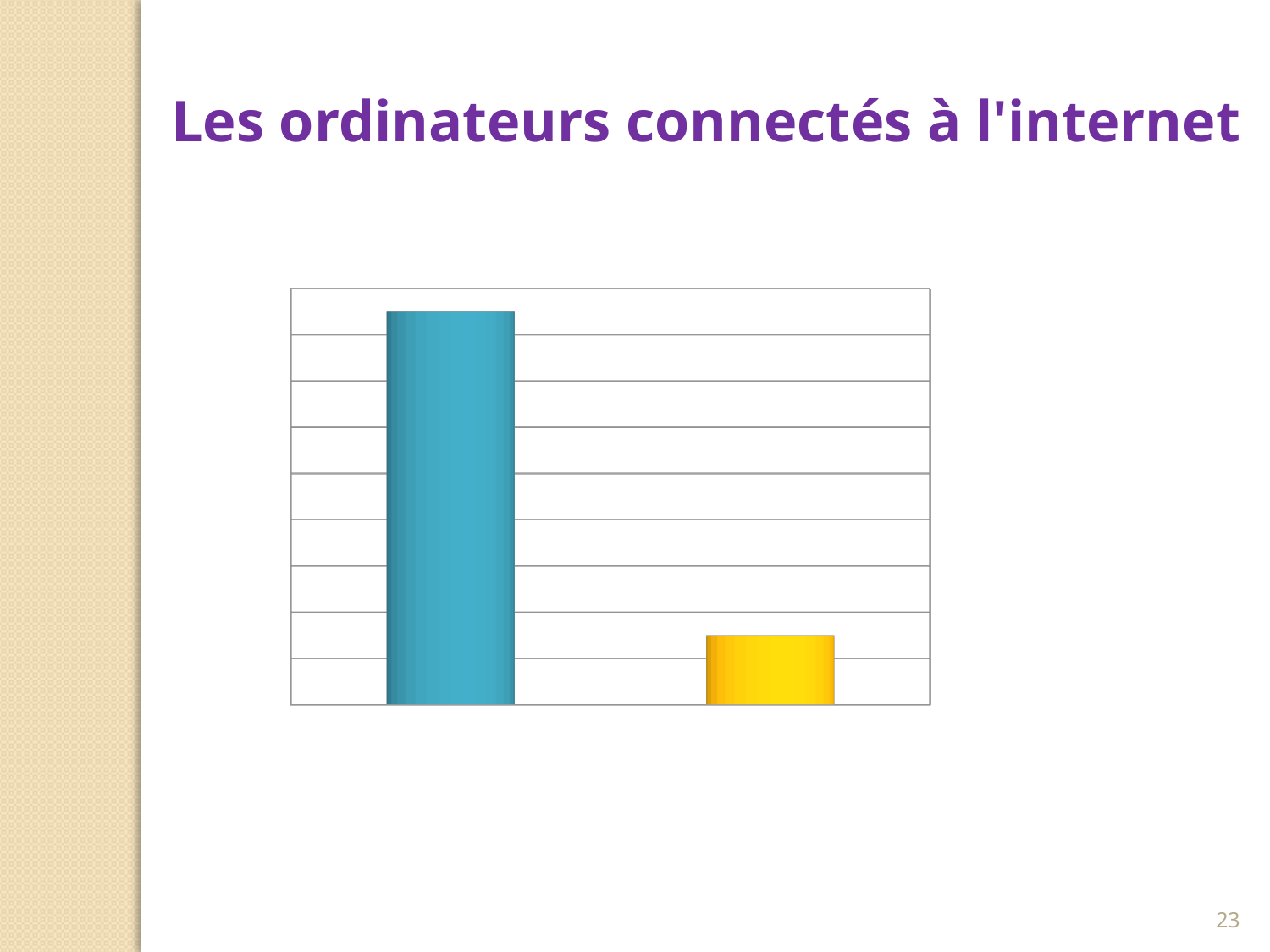
What colours are the two bars in the chart? blue and yellow What kind of chart is shown on the slide? bar chart Which bar is the shortest in the chart? the yellow bar Which bar is the tallest in the chart? the blue bar How many bars does the chart show? 2 Which bar is taller, the blue bar or the yellow bar? the blue bar What is the title of the slide containing the chart? Les ordinateurs connectés à l'internet